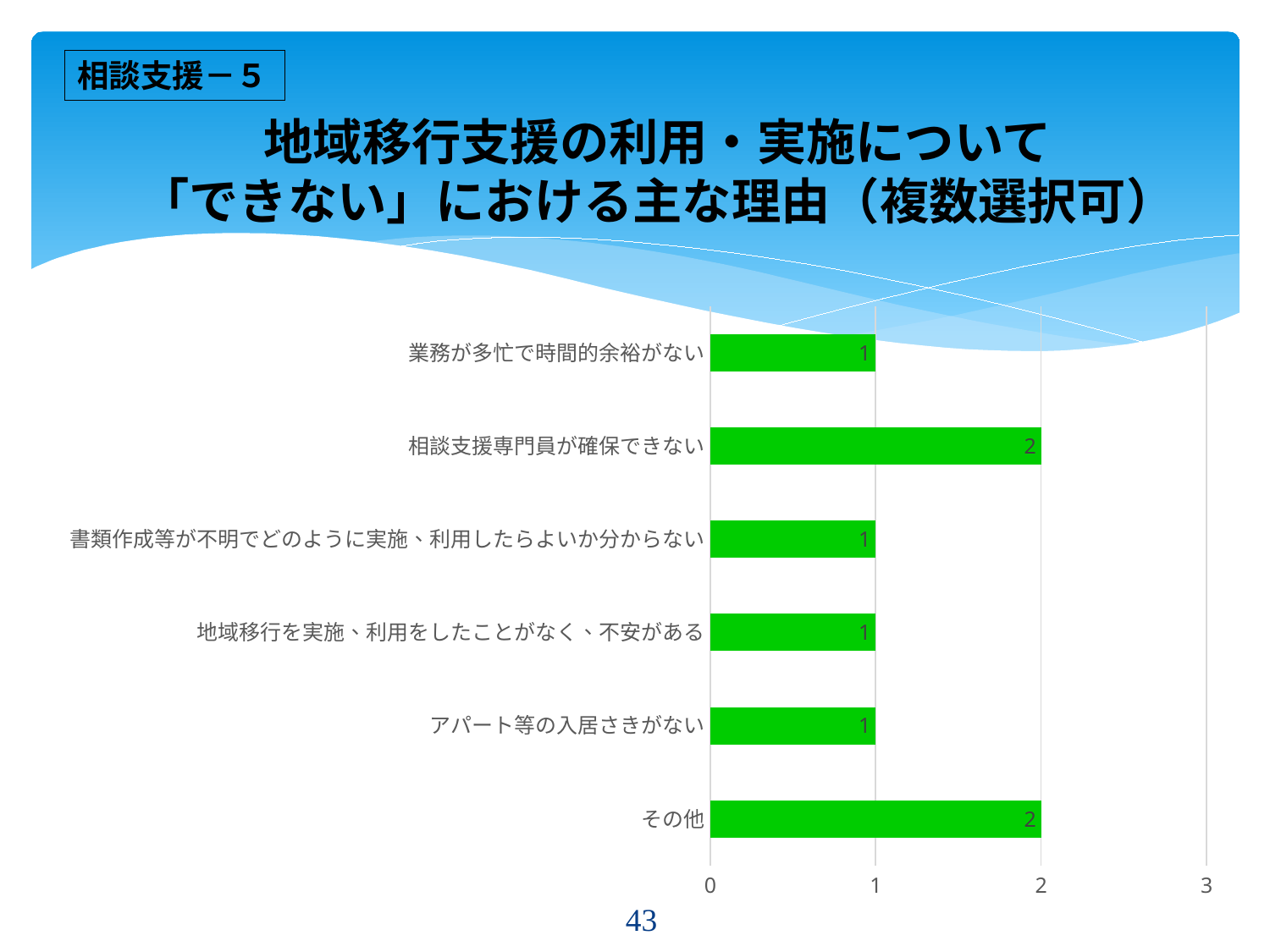
What is the value for 相談支援専門員が確保できない? 2 What is the value for アパート等の入居さきがない? 1 What is the value for 業務が多忙で時間的余裕がない? 1 Which is larger, the value for 相談支援専門員が確保できない or the value for アパート等の入居さきがない? 相談支援専門員が確保できない What is the value for 書類作成等が不明でどのように実施、利用したらよいか分からない? 1 What colour are the bars in the chart? green What is the value for 地域移行を実施、利用をしたことがなく、不安がある? 1 How many categories are shown in the chart? 6 What kind of chart is shown on the slide? bar chart What is the value for その他? 2 Is the value for 相談支援専門員が確保できない greater or less than 3? less What is the difference between the value for その他 and the value for 業務が多忙で時間的余裕がない? 1